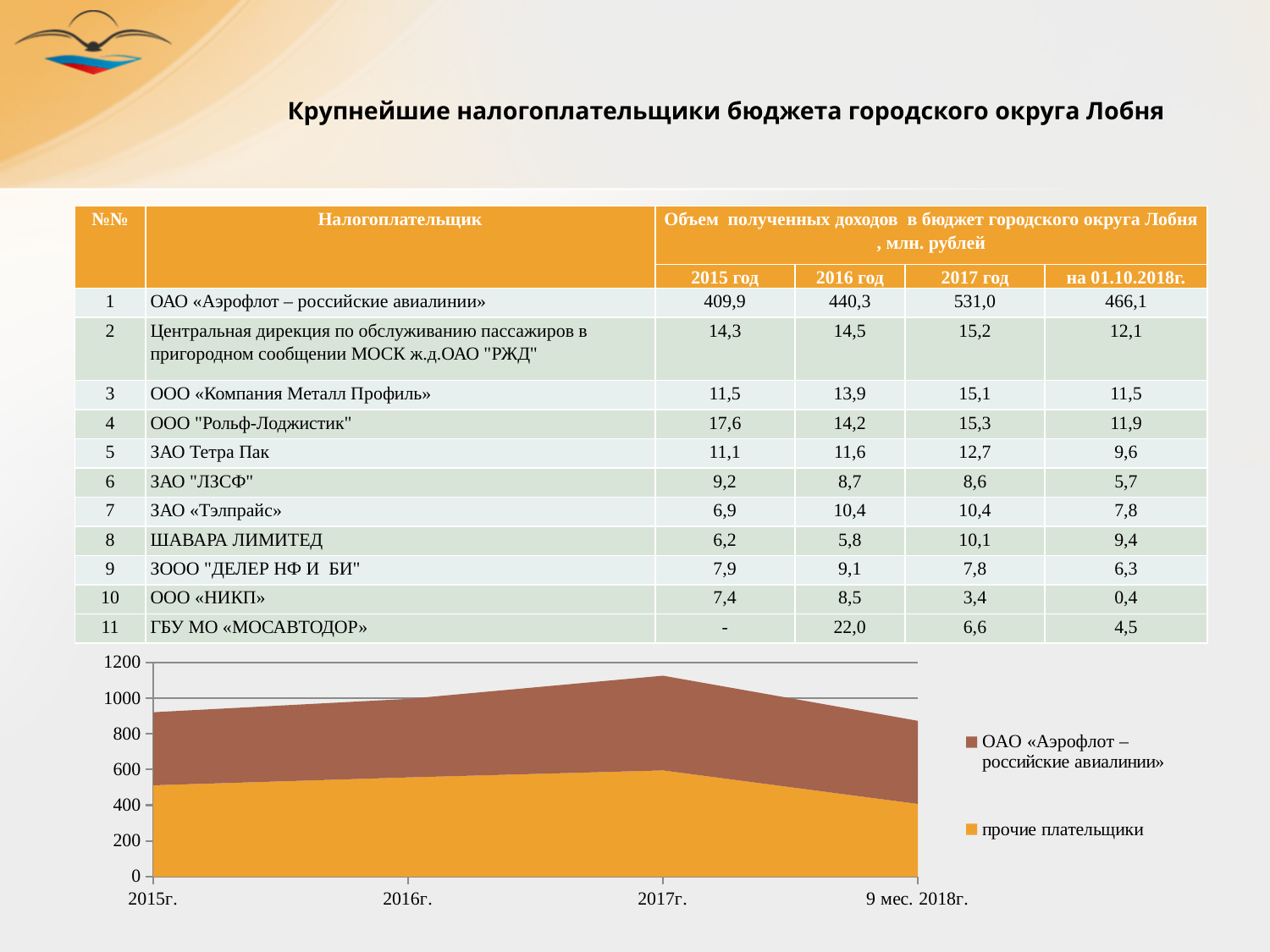
Does the combined total of both series rise or fall from 2017г. to 9 мес. 2018г.? fall How many periods are shown along the x axis of the chart? 4 In which period is the combined total of both series highest? 2017г. Which series is shown in brown in the chart? ОАО «Аэрофлот – российские авиалинии» Is the combined total of both series in 2017г. greater or less than 1000? greater What kind of chart is shown at the bottom of the slide? Stacked area chart Which series is shown in orange in the chart? прочие плательщики Is the combined total of both series in 2015г. greater or less than 1000? less How many series does the chart legend list? 2 Is the combined total of both series in 9 мес. 2018г. greater or less than 1000? less